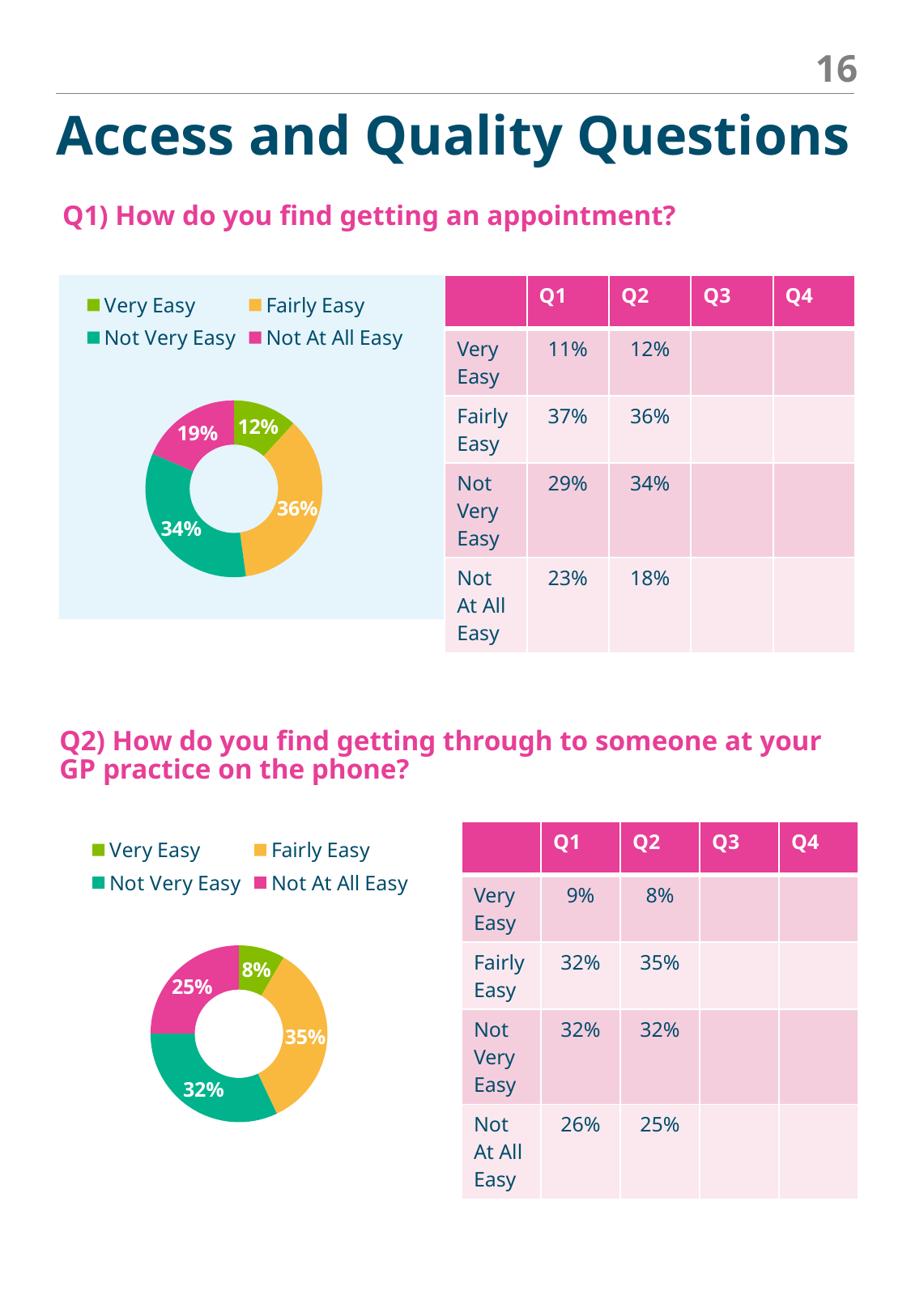
How many categories does the legend of the bottom chart (Q2) list? 4 In the top chart (Q1, getting an appointment), what percentage is shown for Very Easy? 12% In the bottom chart (Q2, getting through on the phone), which is larger: Not Very Easy or Not At All Easy? Not Very Easy What kind of chart is used for Q1 (getting an appointment)? Donut (pie) chart In the top chart (Q1, getting an appointment), what colour represents Not At All Easy? Pink In the top chart (Q1, getting an appointment), which category has the largest share? Fairly Easy In the top chart (Q1, getting an appointment), which category has the smallest share? Very Easy In the top chart (Q1, getting an appointment), what is the difference between the Fairly Easy and Not At All Easy shares? 17 percentage points In the bottom chart (Q2, getting through on the phone), what percentage is shown for Not At All Easy? 25% In the bottom chart (Q2, getting through on the phone), what percentage is shown for Fairly Easy? 35% In the top chart (Q1, getting an appointment), what percentage is shown for Not Very Easy? 34% In the bottom chart (Q2, getting through on the phone), which category has the smallest share? Very Easy